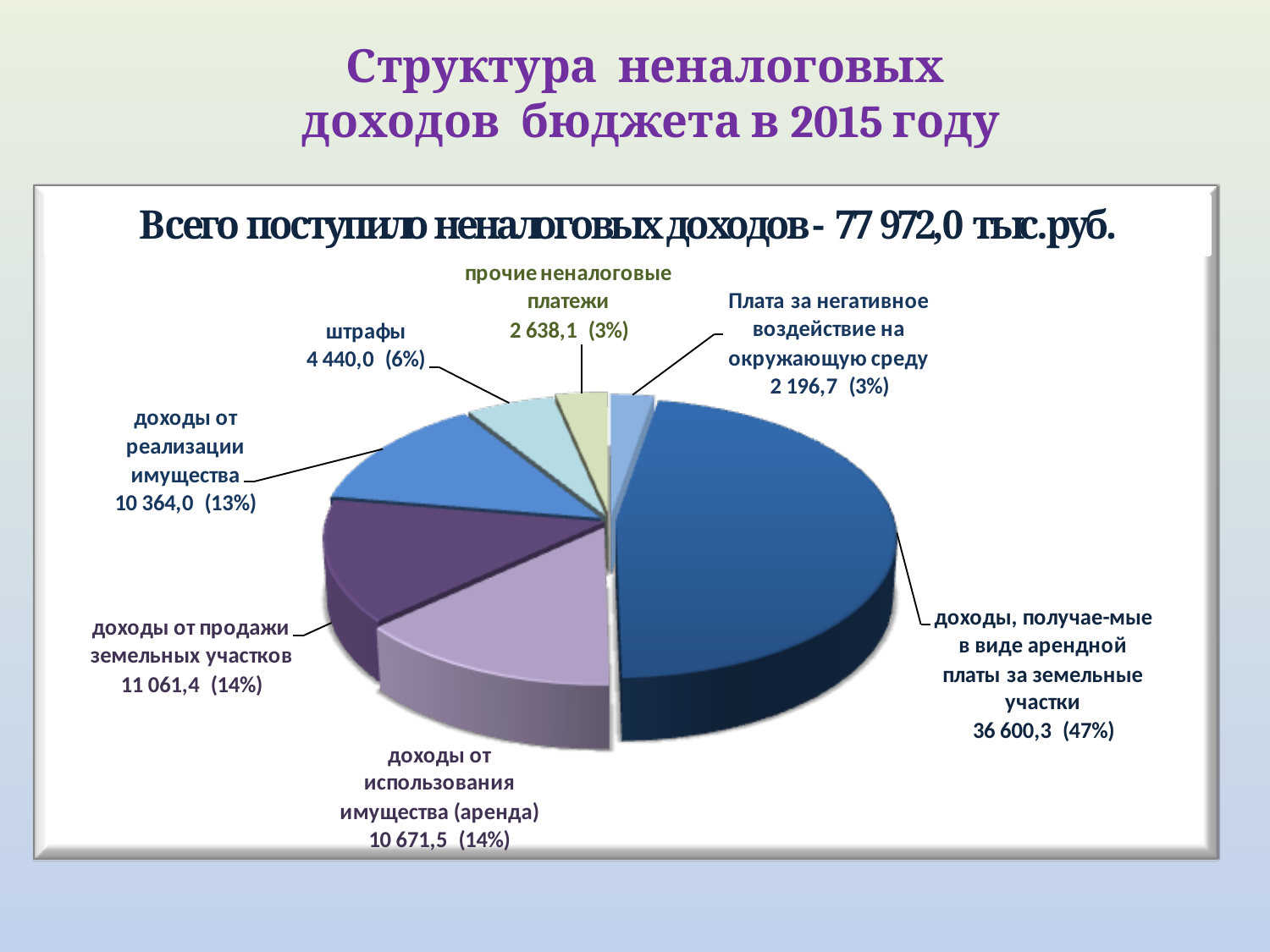
How many slices does the pie chart have? 7 Which category has the largest slice of the pie? доходы, получаемые в виде арендной платы за земельные участки Which category has the smallest slice of the pie? Плата за негативное воздействие на окружающую среду What total amount of non-tax revenue is stated in the chart title? 77 972,0 тыс.руб. What share of the pie does «доходы, получаемые в виде арендной платы за земельные участки» represent? 47% What is the value for «доходы от реализации имущества»? 10 364,0 (13%) What type of chart is shown on the slide? Pie chart What is the value for «штрафы»? 4 440,0 (6%) Which is larger: «доходы от продажи земельных участков» or «доходы от реализации имущества»? доходы от продажи земельных участков What is the value for «Плата за негативное воздействие на окружающую среду»? 2 196,7 (3%) What is the difference between the values for «штрафы» and «прочие неналоговые платежи»? 1 801,9 What share of the pie does «доходы от продажи земельных участков» represent? 14%